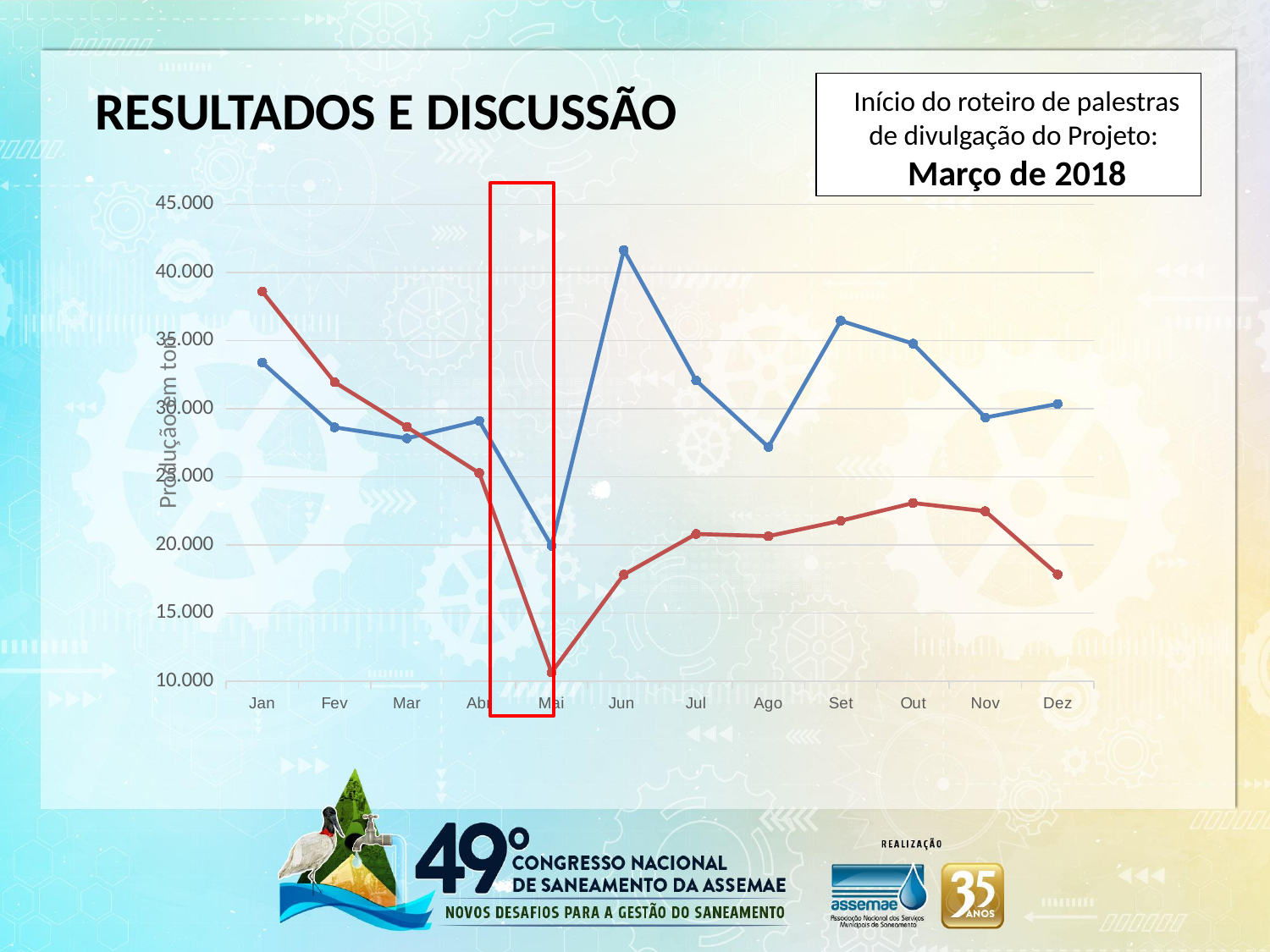
In Jan, which line has the higher value, the blue line or the red line? the red line Is the value of the red line in Dez greater or less than 20.000? less In which month does the red line reach its lowest value? Mai Is the value of the blue line in Jun greater or less than 40.000? greater In which month does the blue line reach its lowest value? Mai How many months are shown on the x axis of the chart? 12 Does the red line rise or fall from Jan to Mai? fall What kind of chart is shown on the slide? line chart Which month on the x axis is highlighted by the red rectangle? Mai In which month does the red line reach its highest value? Jan In which month does the blue line reach its highest value? Jun Is the value of the red line in Mai greater or less than 15.000? less